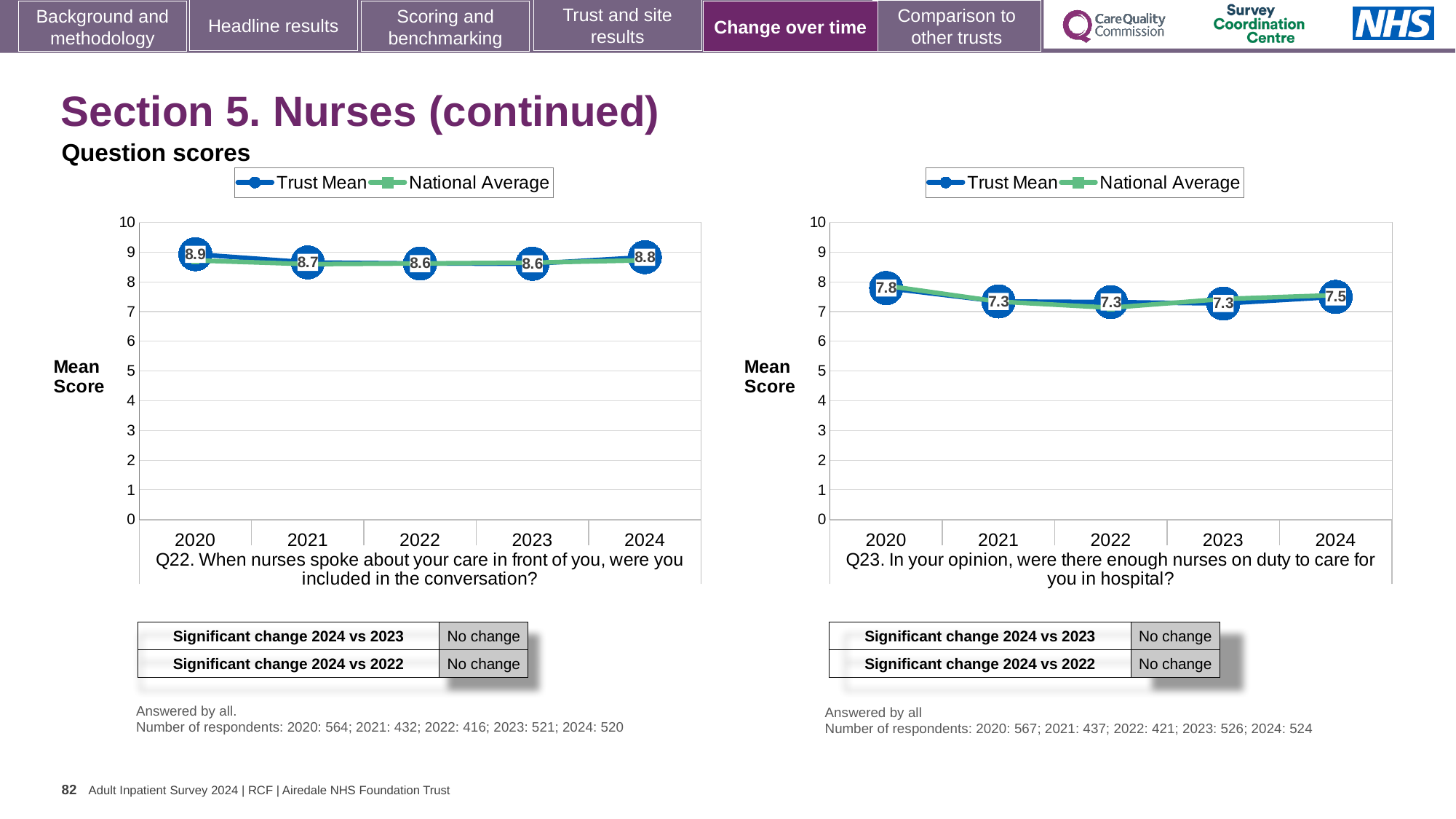
On the Q23 chart (right), what is the Trust Mean score for 2024? 7.5 On the Q23 chart (right), is the Trust Mean value for 2021 greater or less than 8? less What type of chart is used for the Q22 chart (left)? Line chart On the Q22 chart (left), what is the Trust Mean score for 2020? 8.9 On the Q23 chart (right), what is the difference between the Trust Mean score in 2020 and in 2024? 0.3 On the Q23 chart (right), what is the Trust Mean score for 2020? 7.8 How many years are plotted on the Q22 chart (left)? 5 On the Q22 chart (left), what is the Trust Mean score for 2024? 8.8 On the Q22 chart (left), is the Trust Mean score higher in 2020 or in 2022? 2020 How many series does the legend of the Q23 chart (right) list? 2 On the Q22 chart (left), which year has the highest Trust Mean score? 2020 On the Q23 chart (right), which year has the highest Trust Mean score? 2020